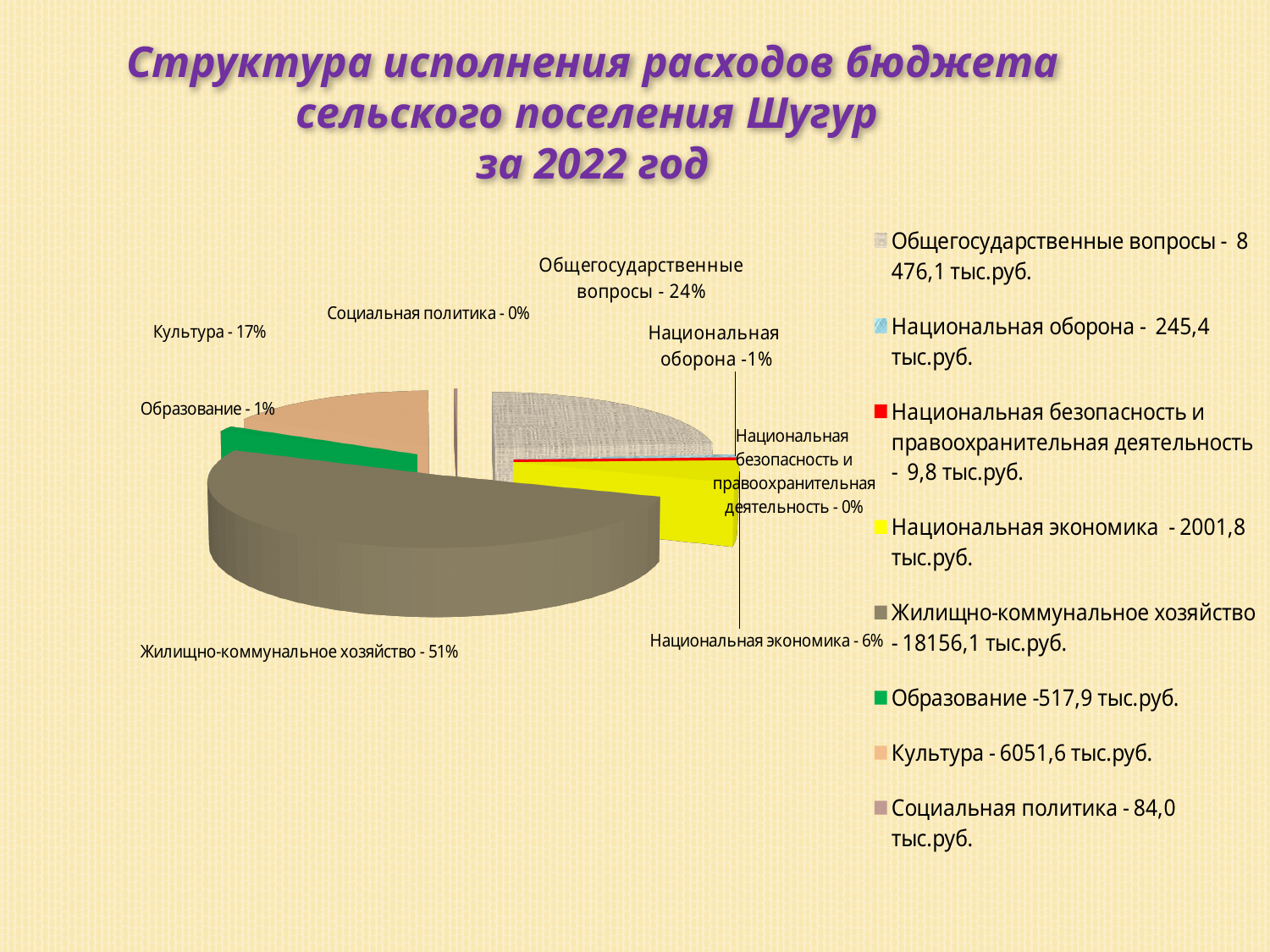
Which category has the largest slice of the pie? Жилищно-коммунальное хозяйство Which has a larger share of the pie, Культура or Национальная экономика? Культура What is the difference in percentage points between the shares of Общегосударственные вопросы and Культура? 7 What value does the legend give for Национальная оборона? 245,4 тыс.руб. Which category has the smallest value in the legend? Национальная безопасность и правоохранительная деятельность What share of the pie does Жилищно-коммунальное хозяйство have? 51% What share of the pie does Общегосударственные вопросы have? 24% How many categories does the legend list? 8 What share of the pie does Национальная экономика have? 6% What value does the legend give for Образование? 517,9 тыс.руб. What kind of chart is shown on the slide? pie chart